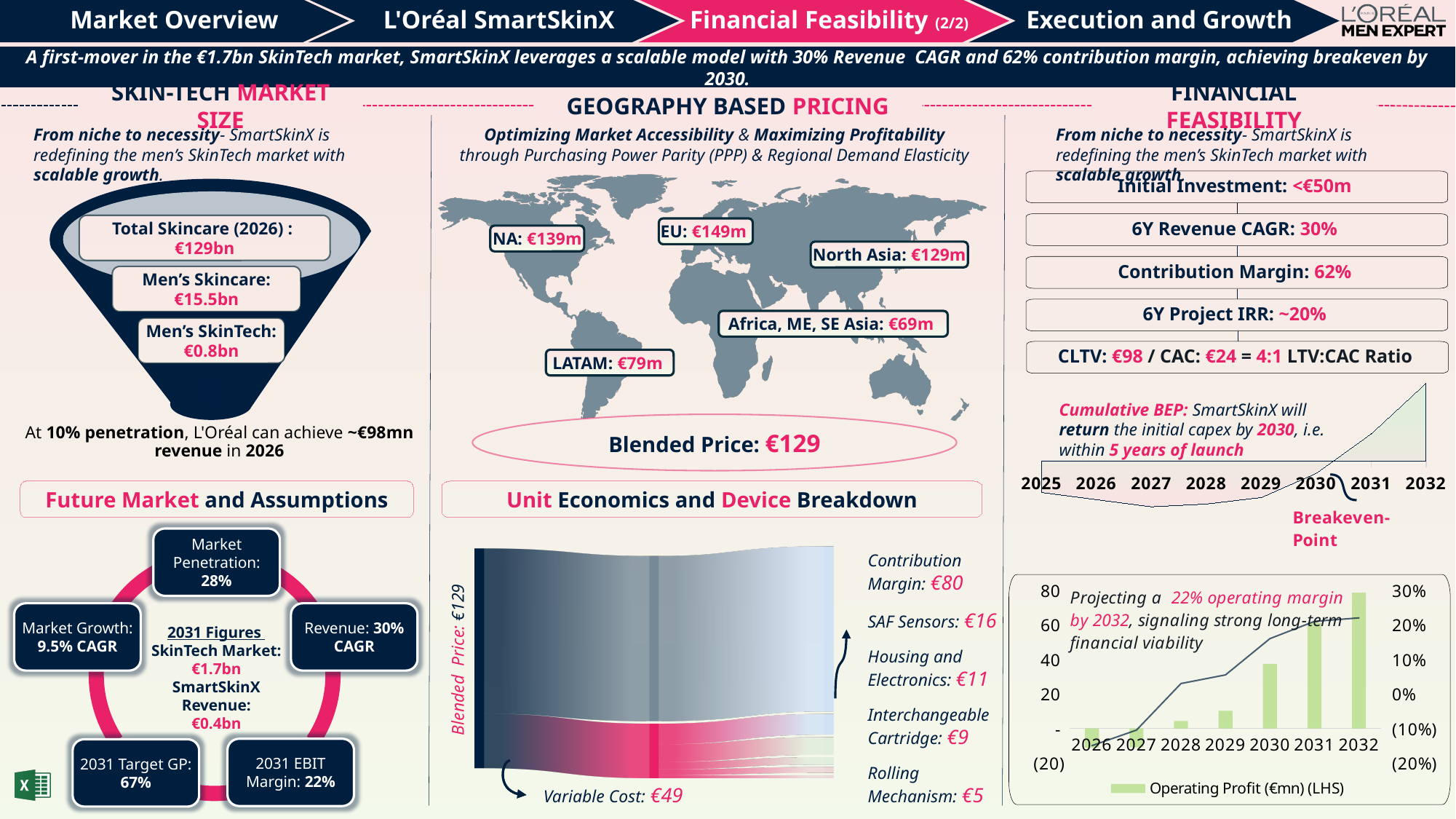
In the operating profit chart at the bottom right, which year has the highest operating profit bar? 2032 What is the legend entry shown below the operating profit chart at the bottom right? Operating Profit (€mn) (LHS) In the operating profit chart at the bottom right, is the operating profit for 2032 greater or less than 60? greater In the operating profit chart at the bottom right, how many years are shown on the x axis? 7 How many entries does the legend of the operating profit chart at the bottom right list? 1 In the operating profit chart at the bottom right, is the operating profit for 2031 greater or less than 40? greater What kind of chart is the chart at the bottom right of the slide showing operating profit? bar chart with a line In the operating profit chart at the bottom right, do the operating profit bars rise or fall from 2026 to 2032? rise In the Cumulative BEP chart on the right of the slide, which year is labelled as the Breakeven-Point? 2030 In the operating profit chart at the bottom right, is the operating profit for 2029 greater or less than 20? less In the operating profit chart at the bottom right, which year has the larger operating profit bar, 2029 or 2031? 2031